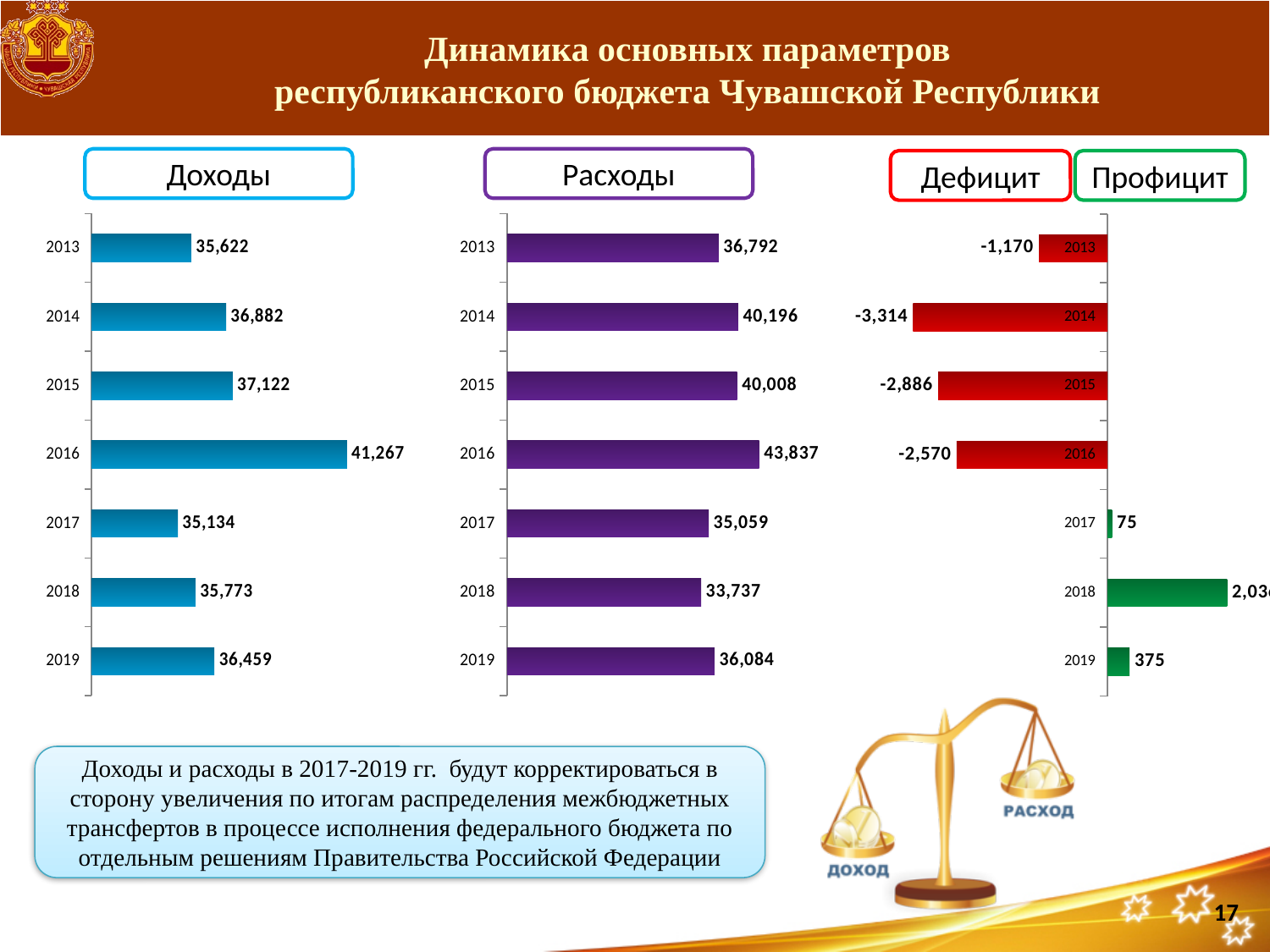
In the Дефицит/Профицит chart, which year has the largest deficit (most negative value)? 2014 In the Дефицит/Профицит chart, what is the value for 2019? 375 In the Доходы chart, which year has the highest value? 2016 How many years are shown in the Доходы chart? 7 In the Доходы chart, what is the value for 2016? 41,267 What colour are the bars in the Доходы chart? blue What type of chart is the Расходы chart? bar chart In the Доходы chart, what is the difference between the values for 2016 and 2017? 6,133 In the Расходы chart, what is the value for 2014? 40,196 In the Дефицит/Профицит chart, what is the value for 2015? -2,886 In the Расходы chart, which year has the lowest value? 2018 In the Расходы chart, which is larger, the value for 2013 or the value for 2019? 2013